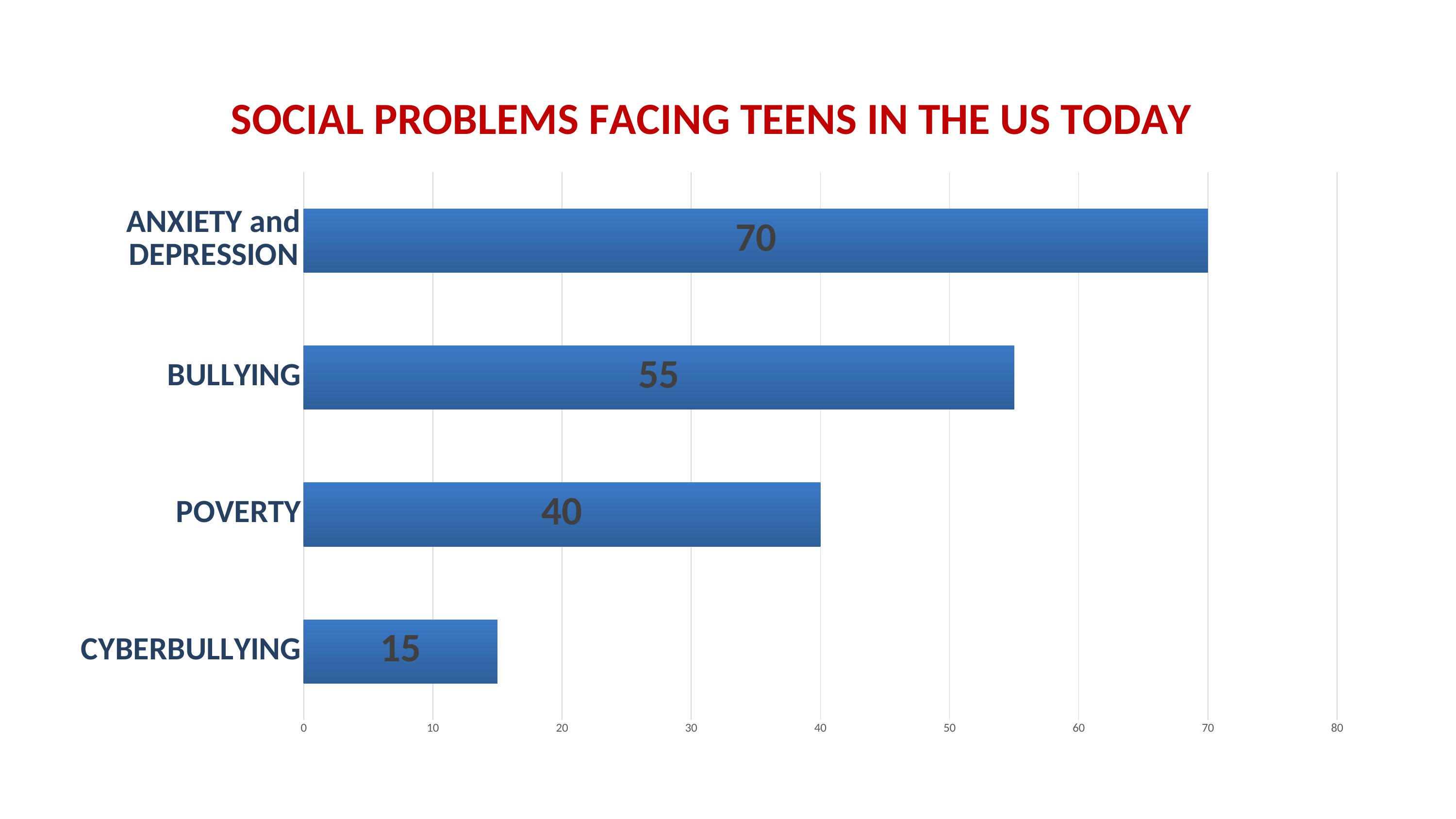
What is the difference between the values for ANXIETY and DEPRESSION and BULLYING? 15 How many categories are shown in the chart? 4 What is the title of the chart? SOCIAL PROBLEMS FACING TEENS IN THE US TODAY What is the value for ANXIETY and DEPRESSION? 70 Which is larger, the value for BULLYING or the value for POVERTY? BULLYING What kind of chart is shown on the slide? Bar chart Which category has the highest value? ANXIETY and DEPRESSION Which category has the lowest value? CYBERBULLYING What is the value for CYBERBULLYING? 15 What is the difference between the values for POVERTY and CYBERBULLYING? 25 What is the value for POVERTY? 40 What is the value for BULLYING? 55